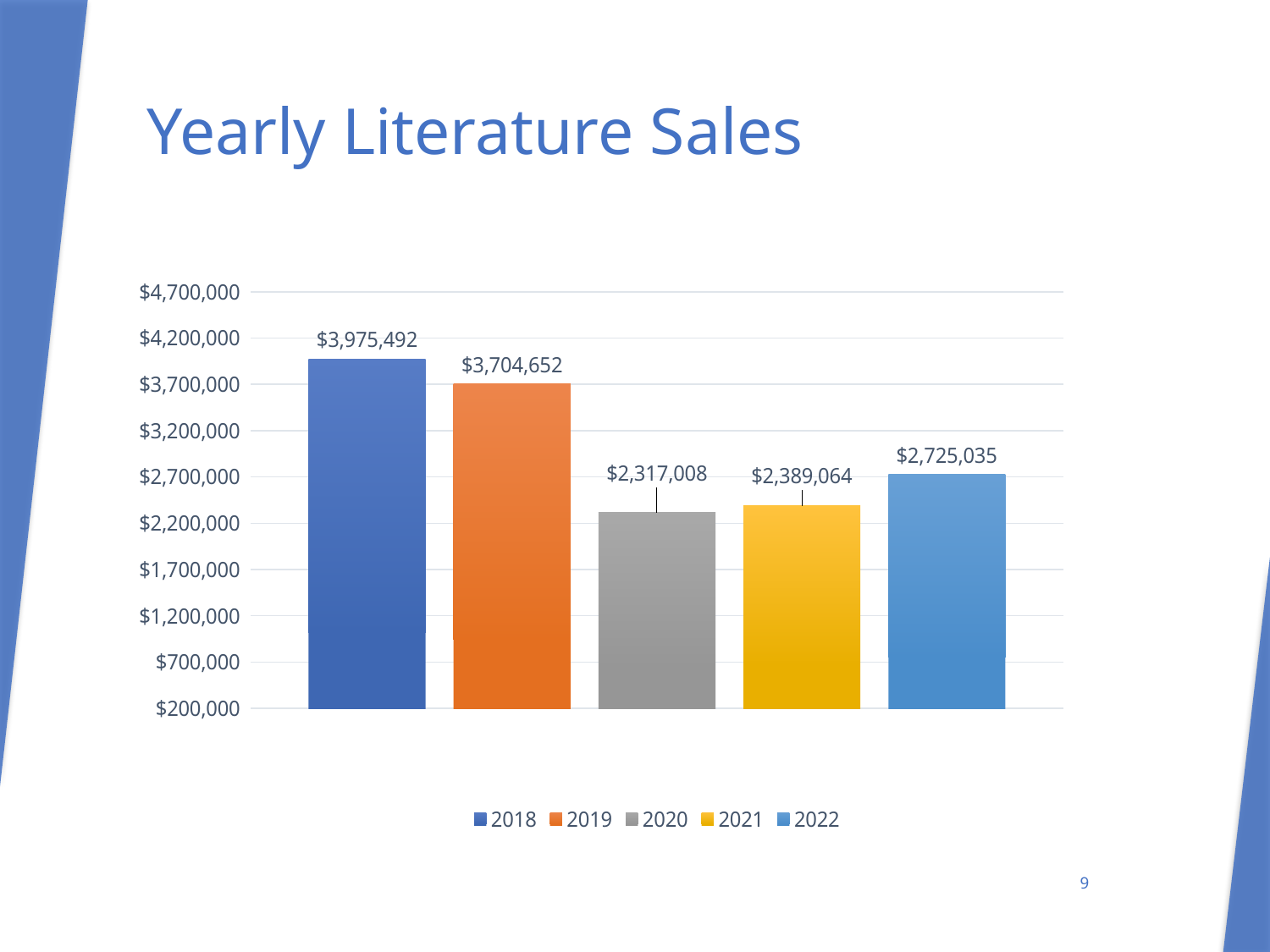
What kind of chart is shown on the slide? Bar chart What is the difference between the 2022 and 2021 values? $335,971 What is the value for 2022? $2,725,035 What is the difference between the 2018 and 2019 values? $270,840 What is the value for 2020? $2,317,008 How many bars are shown in the chart? 5 Do the values rise or fall from 2018 to 2020? Fall Which year has the lowest sales? 2020 How many entries does the legend list? 5 Which year has the highest sales? 2018 Which is larger, the value for 2019 or the value for 2022? 2019 What is the value for 2018? $3,975,492